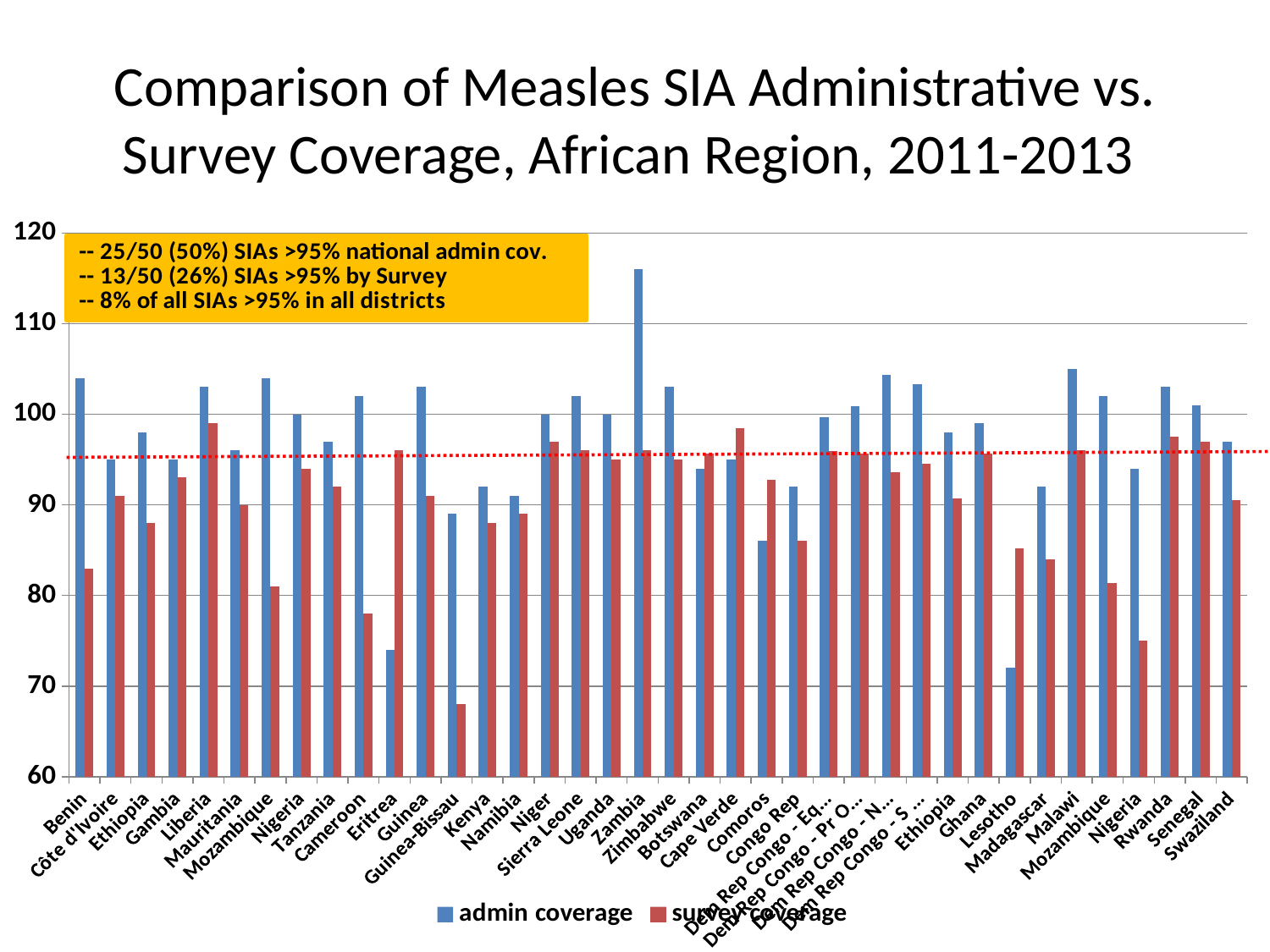
For Benin, which is larger: admin coverage or survey coverage? admin coverage Is the survey coverage value for Guinea-Bissau greater or less than 70? less Which country has the lowest survey coverage bar? Guinea-Bissau How many series does the legend list? 2 What kind of chart is shown on the slide? bar chart Which country has the highest admin coverage bar? Zambia Is the admin coverage value for Zambia greater or less than 110? greater What are the two series named in the legend? admin coverage and survey coverage For Eritrea, which is larger: admin coverage or survey coverage? survey coverage Is the admin coverage value for Eritrea greater or less than 80? less